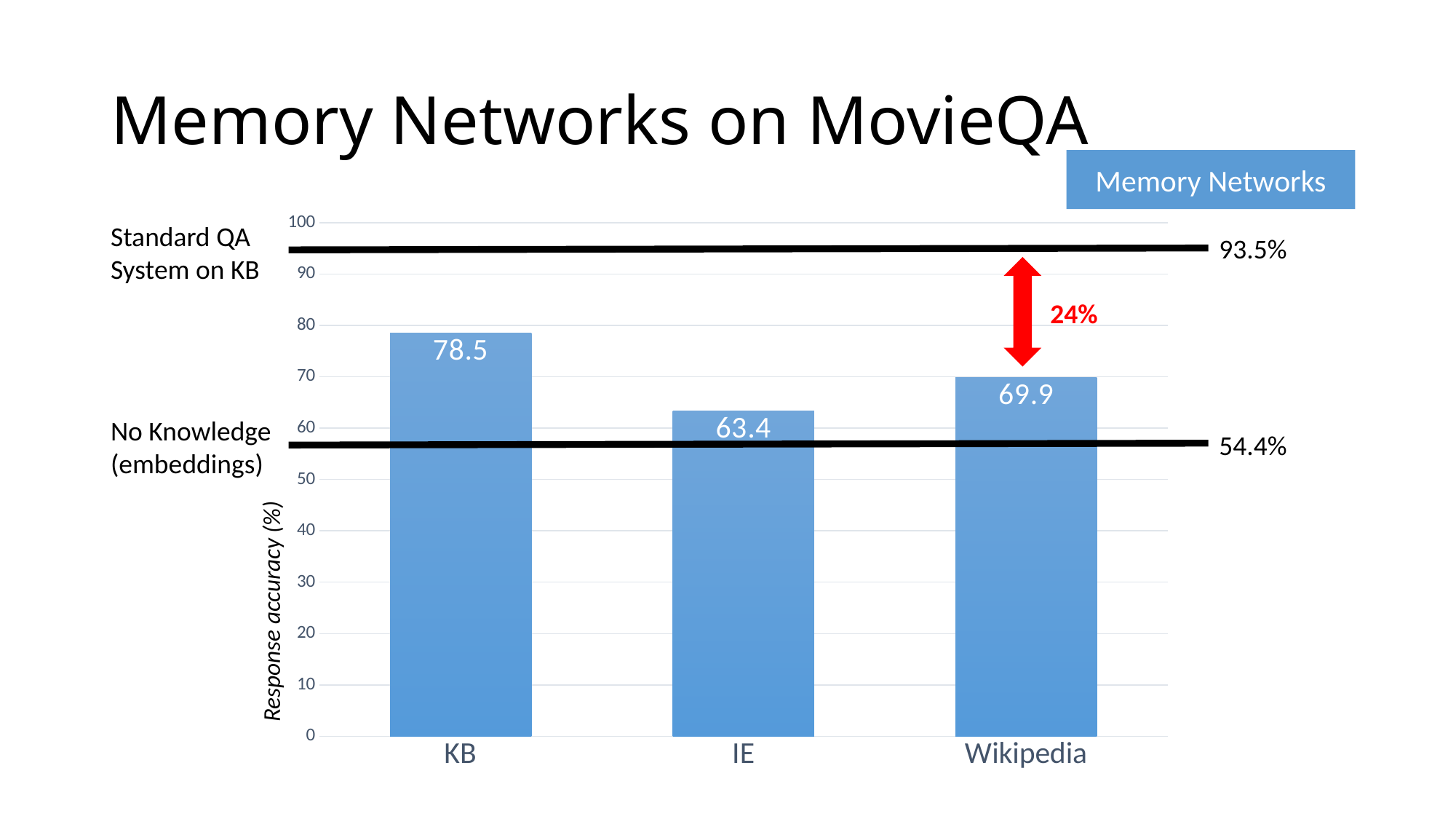
What is the response accuracy for Wikipedia? 69.9 How many knowledge sources are shown on the x axis? 3 Which has a higher response accuracy, IE or Wikipedia? Wikipedia What kind of chart is shown on the slide? bar chart What is the response accuracy for IE? 63.4 Which knowledge source has the lowest response accuracy? IE What is the response accuracy for KB? 78.5 Which knowledge source has the highest response accuracy? KB What is the difference in response accuracy between KB and Wikipedia? 8.6 Is the value for IE greater or less than 70? less What is the difference in response accuracy between KB and IE? 15.1 What accuracy is shown for the Standard QA System on KB reference line? 93.5%